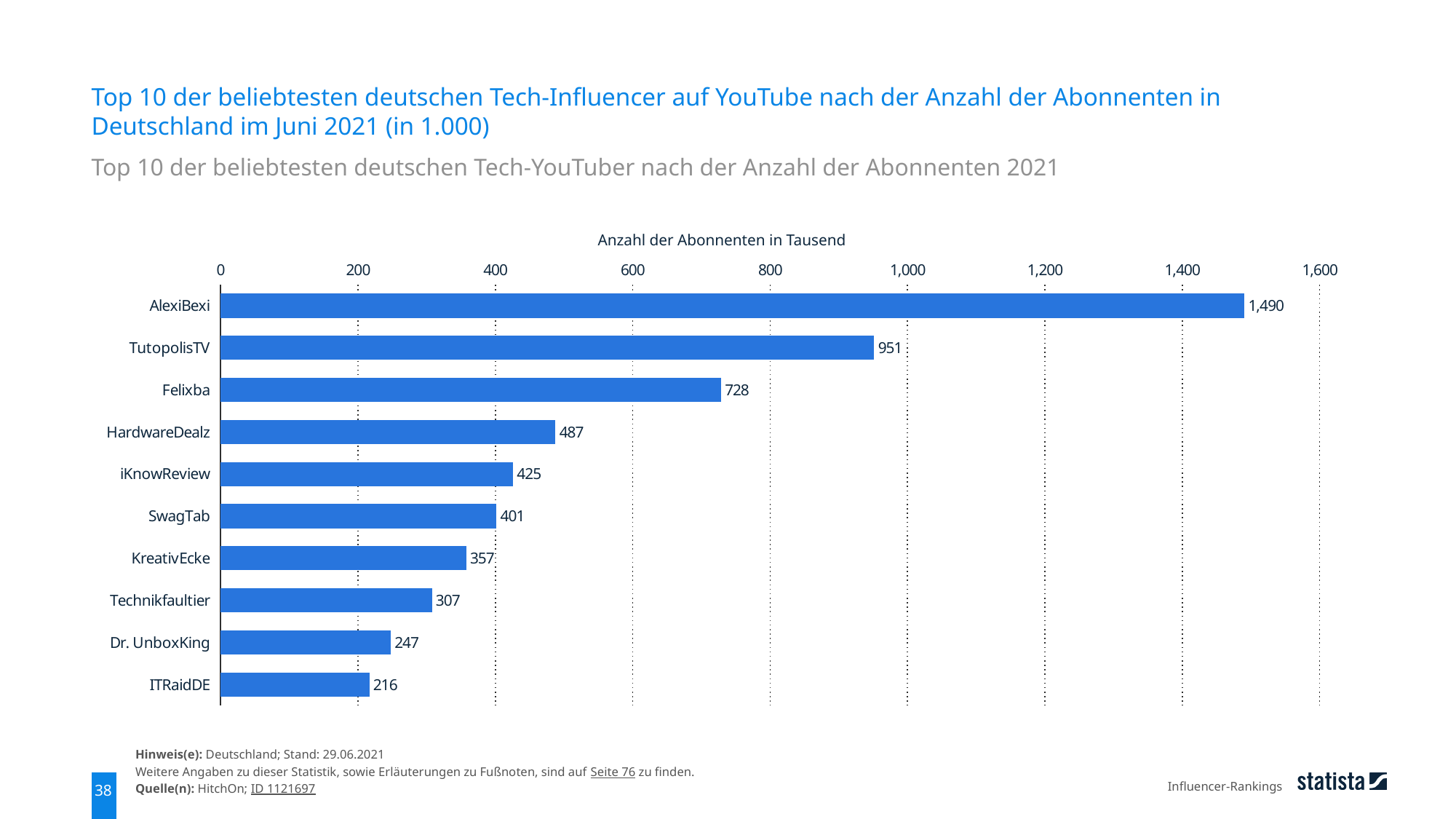
What is the value for HardwareDealz? 487 What is the value for Dr. UnboxKing? 247 How many categories are shown in the chart? 10 What is the value for AlexiBexi? 1,490 Which category has the lowest value? ITRaidDE Which is larger, the value for iKnowReview or the value for SwagTab? iKnowReview What is the difference between the values for TutopolisTV and Felixba? 223 Is the value for KreativEcke greater or less than 400? less Which category has the highest value? AlexiBexi What is the axis title shown above the chart? Anzahl der Abonnenten in Tausend What kind of chart is shown on the slide? bar chart What is the difference between the values for Technikfaultier and ITRaidDE? 91